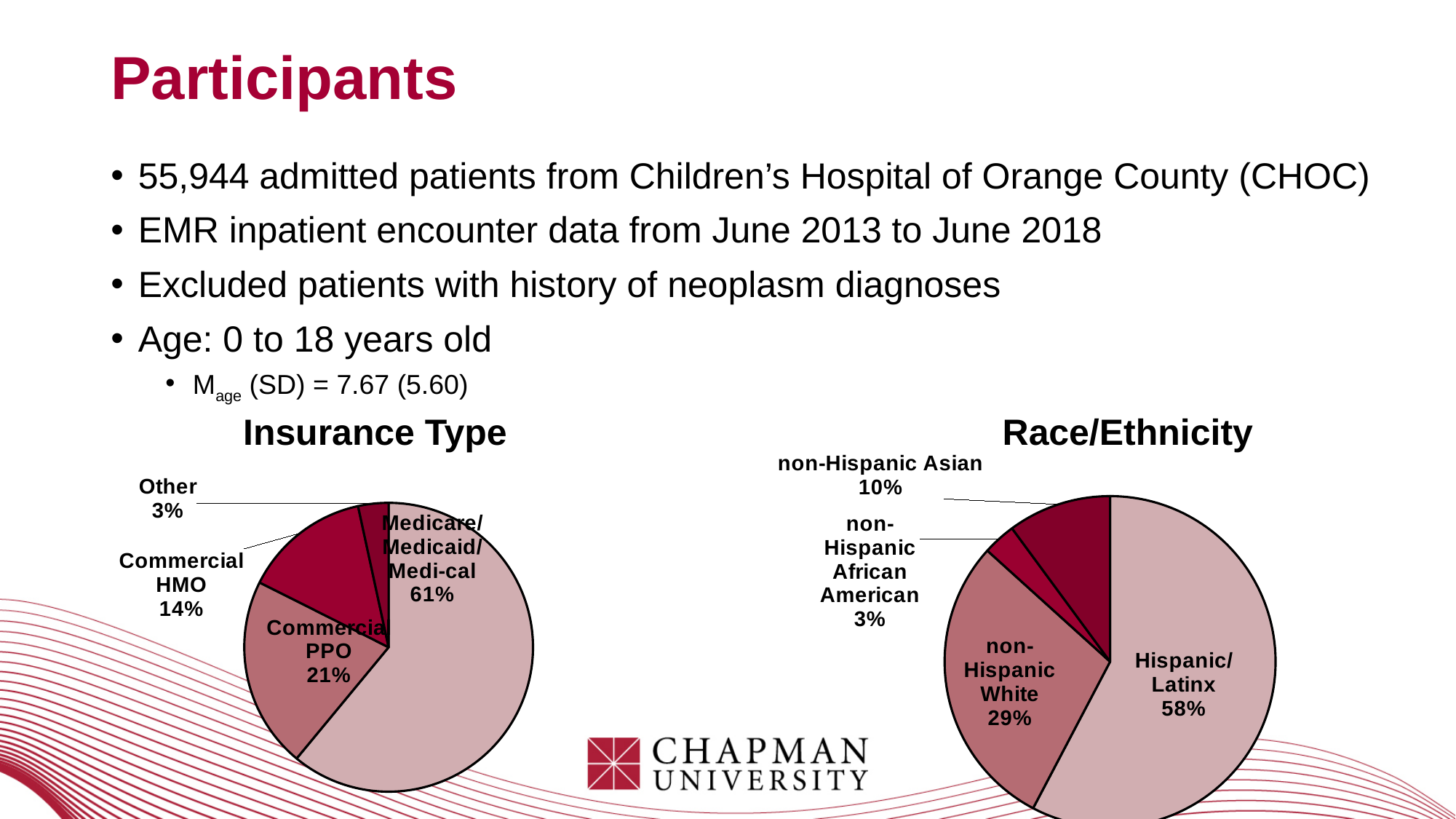
In the Insurance Type chart, what is the difference in percentage points between Commercial PPO and Commercial HMO? 7 In the Race/Ethnicity chart, what share of participants are Hispanic/Latinx? 58% In the Insurance Type chart, what percentage is labelled for Commercial PPO? 21% In the Race/Ethnicity chart, what is the difference in percentage points between Hispanic/Latinx and non-Hispanic White? 29 In the Insurance Type chart, how many slices does the pie have? 4 In the Race/Ethnicity chart, what percentage is labelled for non-Hispanic Asian? 10% In the Insurance Type chart, what share of participants have Medicare/Medicaid/Medi-cal insurance? 61% In the Insurance Type chart, which insurance type has the smallest slice? Other In the Insurance Type chart, which insurance type has the largest slice? Medicare/Medicaid/Medi-cal What type of chart is used for the Race/Ethnicity data? Pie chart In the Race/Ethnicity chart, which group has the smallest slice? non-Hispanic African American In the Race/Ethnicity chart, which is larger, non-Hispanic White or non-Hispanic Asian? non-Hispanic White